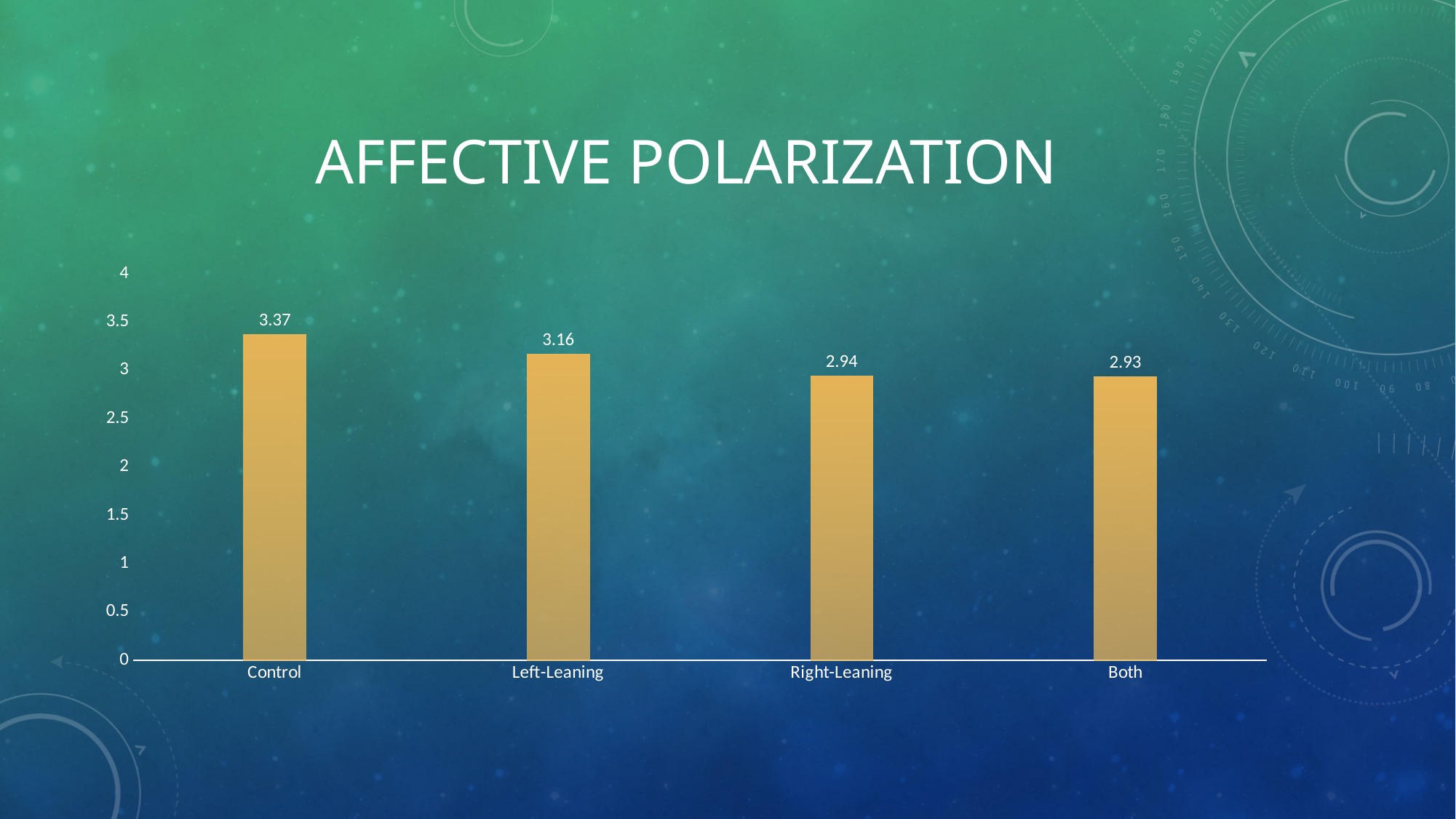
What is the value for Right-Leaning? 2.94 What is the value for Left-Leaning? 3.16 What kind of chart is shown on the slide? Bar chart What is the value for Control? 3.37 Which category has the highest value? Control What is the difference between the values for Control and Left-Leaning? 0.21 How many categories are shown on the x axis? 4 Is the value for Left-Leaning greater or less than 3? greater What is the value for Both? 2.93 Which is larger, the value for Control or the value for Right-Leaning? Control What is the title of the slide? Affective Polarization What is the difference between the values for Left-Leaning and Right-Leaning? 0.22